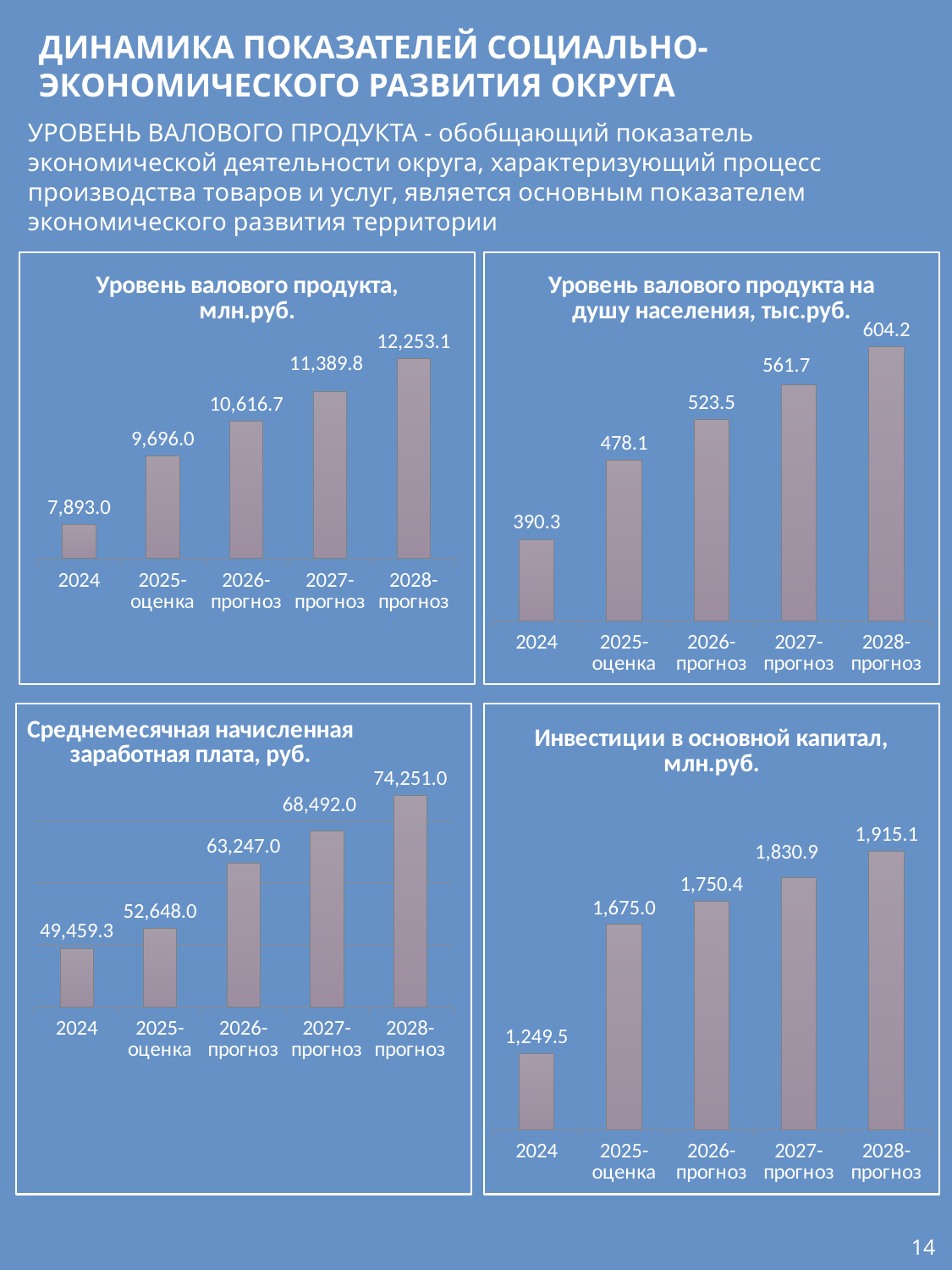
In the chart 'Среднемесячная начисленная заработная плата, руб.', what is the value for 2027-прогноз? 68,492.0 What type of chart is 'Инвестиции в основной капитал, млн.руб.'? bar chart In the chart 'Среднемесячная начисленная заработная плата, руб.', what is the difference between the 2026-прогноз and 2025-оценка values? 10,599.0 In the chart 'Уровень валового продукта, млн.руб.', what is the value for 2024? 7,893.0 In the chart 'Инвестиции в основной капитал, млн.руб.', what is the value for 2025-оценка? 1,675.0 In the chart 'Уровень валового продукта на душу населения, тыс.руб.', what is the value for 2026-прогноз? 523.5 In the chart 'Уровень валового продукта, млн.руб.', what is the difference between the 2028-прогноз and 2024 values? 4,360.1 In the chart 'Инвестиции в основной капитал, млн.руб.', which is larger: the value for 2024 or the value for 2026-прогноз? 2026-прогноз In the chart 'Уровень валового продукта, млн.руб.', which category has the highest value? 2028-прогноз In the chart 'Уровень валового продукта на душу населения, тыс.руб.', do the values rise or fall from 2024 to 2028-прогноз? rise In the chart 'Среднемесячная начисленная заработная плата, руб.', how many categories are shown? 5 In the chart 'Уровень валового продукта на душу населения, тыс.руб.', which category has the lowest value? 2024